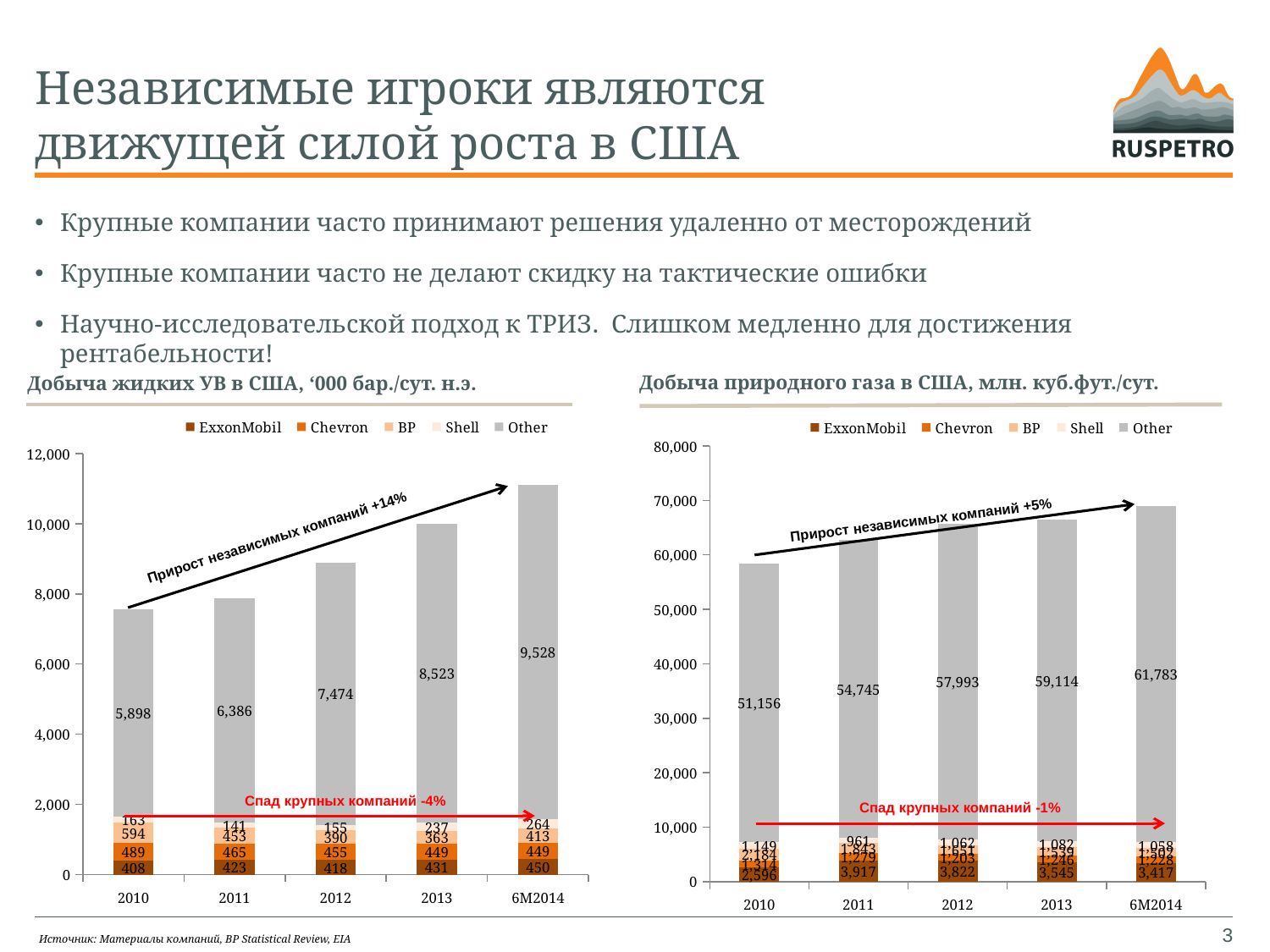
In the chart 'Добыча жидких УВ в США', what is the total of the stacked bar for 2010? 7,552 How many series does the legend list in the chart 'Добыча жидких УВ в США'? 5 In the chart 'Добыча природного газа в США', is the total height of the 2010 bar greater or less than 50,000? greater In the chart 'Добыча жидких УВ в США', what is the value for ExxonMobil in 2013? 431 In the chart 'Добыча природного газа в США', what is the value for ExxonMobil in 2011? 3,917 In the chart 'Добыча природного газа в США', which year has the lowest value for Other? 2010 In the chart 'Добыча жидких УВ в США', which year has the highest value for Other? 6M2014 In the chart 'Добыча природного газа в США', what is the value for Other in 6M2014? 61,783 What kind of chart is 'Добыча природного газа в США'? stacked bar chart In the chart 'Добыча природного газа в США', which is larger: the Other value for 2011 or for 2012? 2012 In the chart 'Добыча жидких УВ в США', what is the difference between the Other values for 2013 and 2012? 1,049 In the chart 'Добыча жидких УВ в США', what is the value for Other in 2012? 7,474